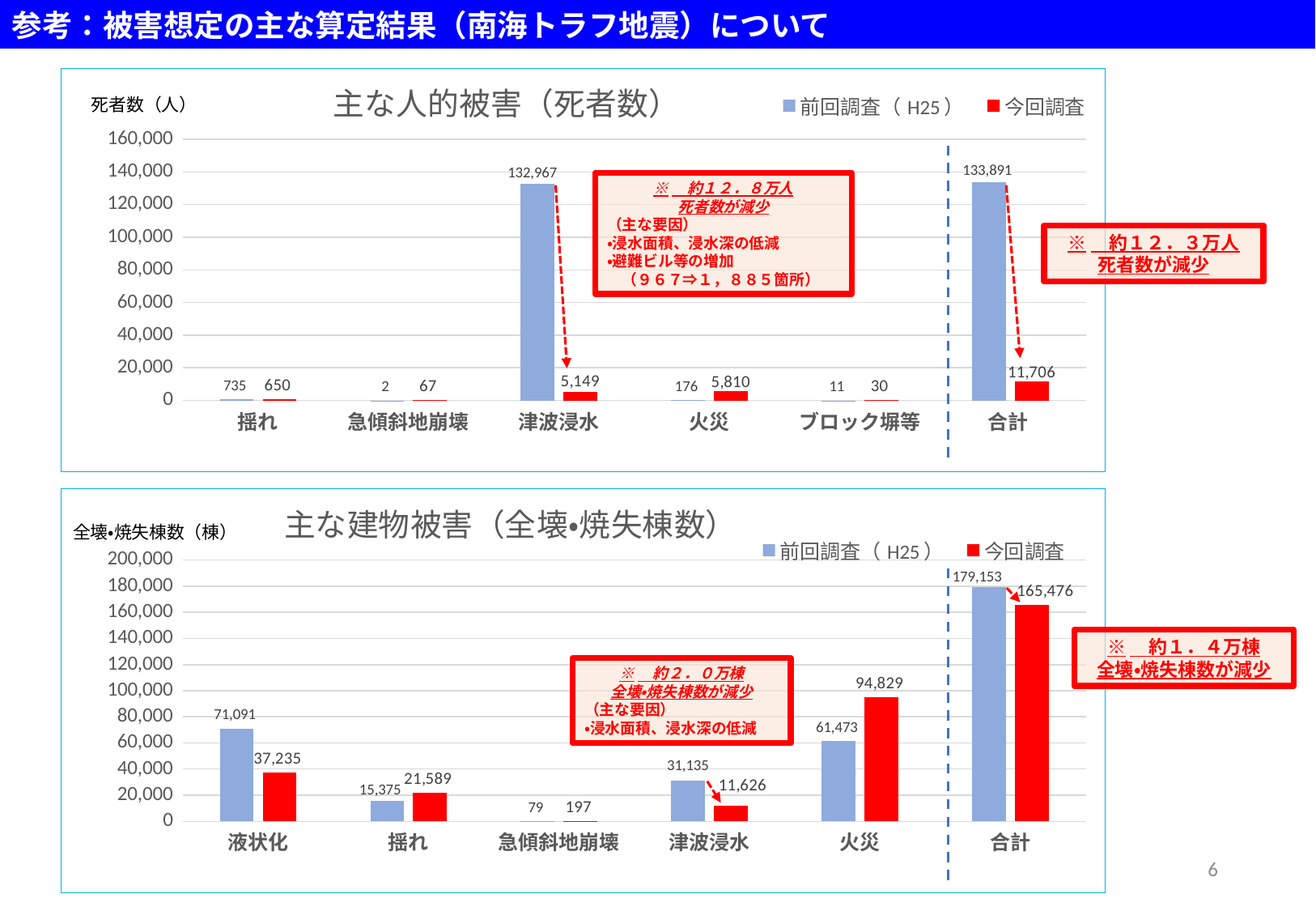
In the top chart (主な人的被害（死者数）), what is the 前回調査（H25） value for 津波浸水? 132,967 In the bottom chart (主な建物被害（全壊・焼失棟数）), which is larger for 揺れ: the 前回調査（H25） value or the 今回調査 value? 今回調査 In the top chart (主な人的被害（死者数）), what is the 今回調査 value for 合計? 11,706 In the bottom chart (主な建物被害（全壊・焼失棟数）), how many categories are shown on the x axis? 6 In the top chart (主な人的被害（死者数）), what is the difference between the 前回調査（H25） and 今回調査 values for 津波浸水? 127,818 In the bottom chart (主な建物被害（全壊・焼失棟数）), what is the difference between the 前回調査（H25） and 今回調査 values for 合計? 13,677 In the top chart (主な人的被害（死者数）), excluding 合計, which category has the highest 前回調査（H25） value? 津波浸水 In the bottom chart (主な建物被害（全壊・焼失棟数）), what is the 前回調査（H25） value for 液状化? 71,091 In the bottom chart (主な建物被害（全壊・焼失棟数）), what is the 今回調査 value for 火災? 94,829 What kind of chart is the bottom chart (主な建物被害（全壊・焼失棟数）)? Bar chart In the top chart (主な人的被害（死者数）), what is the 今回調査 value for 火災? 5,810 In the top chart (主な人的被害（死者数）), how many series does the legend list? 2